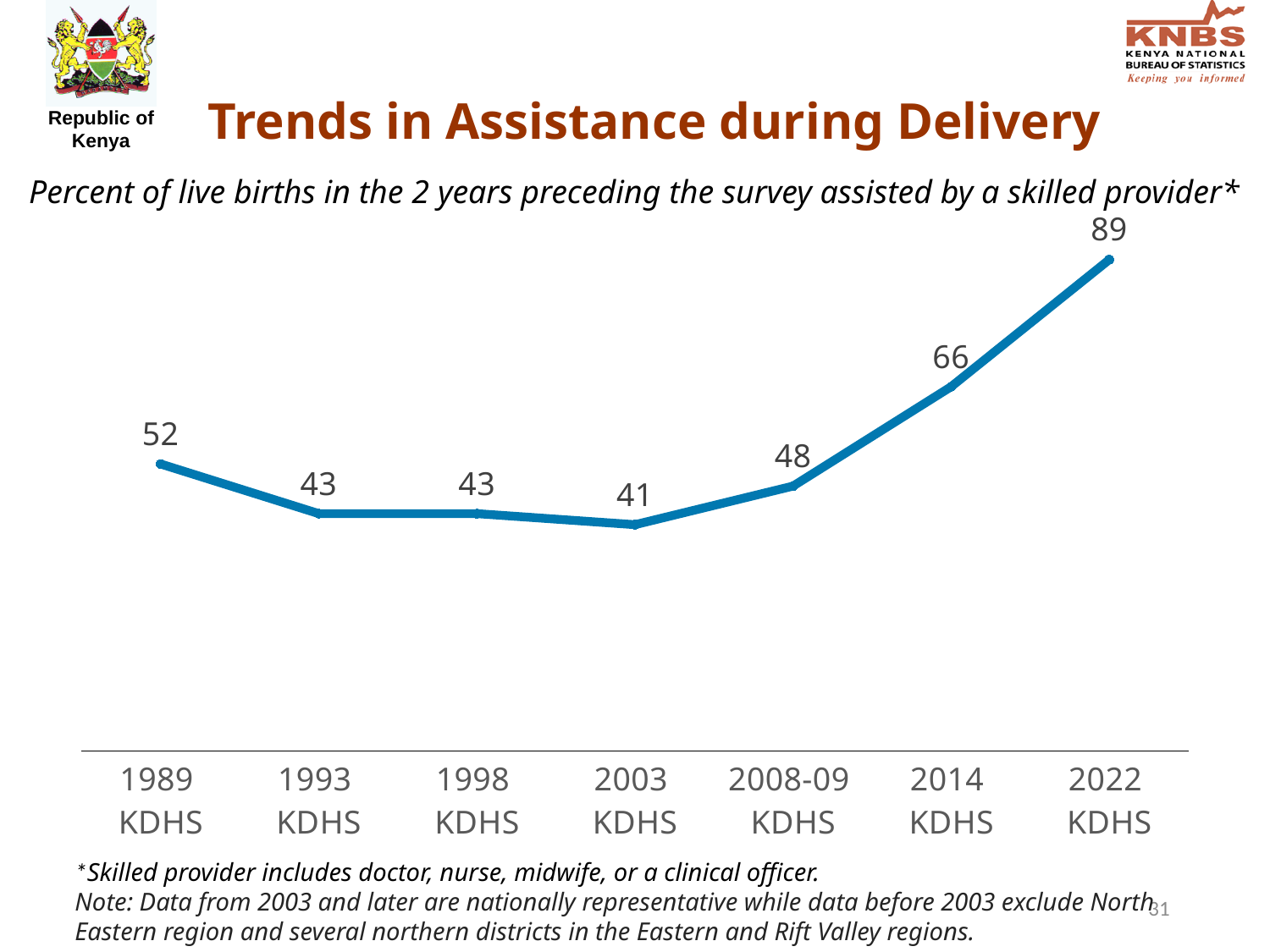
How many survey points are plotted on the chart? 7 What is the value for 2022 KDHS? 89 What is the value for 1989 KDHS? 52 Do the values rise or fall from 2003 KDHS to 2022 KDHS? Rise What is the difference between the values for 1989 KDHS and 2003 KDHS? 11 Which survey year has the highest value? 2022 KDHS What kind of chart is shown on the slide? Line chart Which is larger, the value for 1989 KDHS or the value for 2008-09 KDHS? 1989 KDHS What is the value for 2014 KDHS? 66 What is the difference between the values for 2022 KDHS and 2014 KDHS? 23 Which survey year has the lowest value? 2003 KDHS What is the value for 2008-09 KDHS? 48